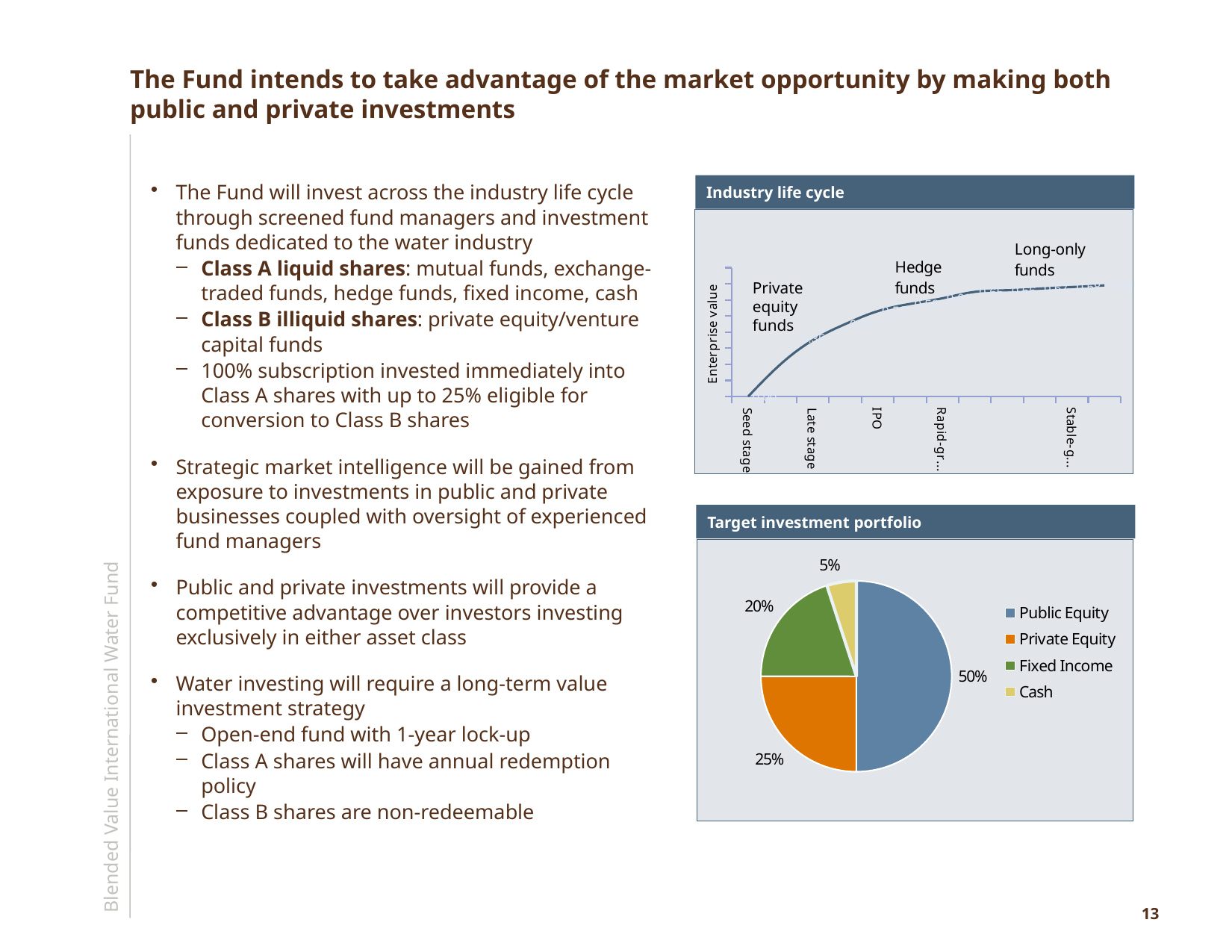
In the Target investment portfolio chart, which is larger, Fixed Income or Private Equity? Private Equity In the Target investment portfolio chart, what share is allocated to Cash? 5% What kind of chart is the Target investment portfolio chart? Pie chart In the Target investment portfolio chart, which category has the smallest share? Cash In the Target investment portfolio chart, which category has the largest share? Public Equity What kind of chart is the Industry life cycle chart? Line chart In the Target investment portfolio chart, what share is allocated to Public Equity? 50% In the Target investment portfolio chart, what share is allocated to Fixed Income? 20% How many categories does the legend of the Target investment portfolio chart list? 4 In the Industry life cycle chart, does enterprise value rise or fall from Seed stage to the right end of the x axis? Rise In the Target investment portfolio chart, what share is allocated to Private Equity? 25% In the Target investment portfolio chart, what is the difference between the Public Equity and Private Equity shares? 25%